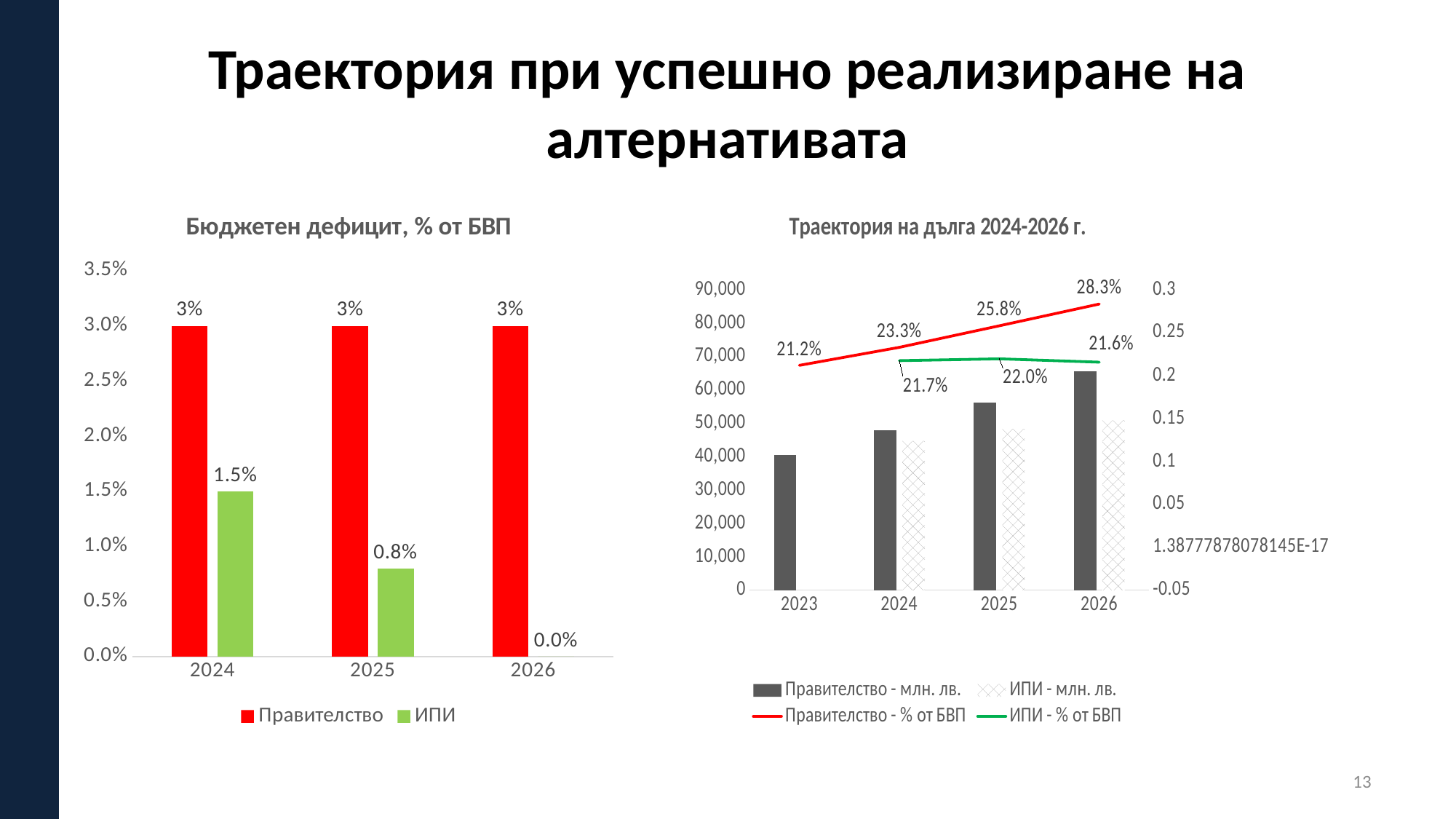
In the chart titled "Бюджетен дефицит, % от БВП", what is the value for ИПИ in 2025? 0.8% In the chart titled "Траектория на дълга 2024-2026 г.", what is the difference between Правителство - % от БВП and ИПИ - % от БВП in 2026? 6.7% In the chart titled "Траектория на дълга 2024-2026 г.", how many series does the legend list? 4 In the chart titled "Траектория на дълга 2024-2026 г.", what is the value of ИПИ - % от БВП in 2025? 22.0% In the chart titled "Бюджетен дефицит, % от БВП", how many series does the legend list? 2 In the chart titled "Бюджетен дефицит, % от БВП", in which year is the ИПИ value lowest? 2026 In the chart titled "Бюджетен дефицит, % от БВП", do the ИПИ values rise or fall from 2024 to 2026? fall In the chart titled "Бюджетен дефицит, % от БВП", what kind of chart is it? bar chart In the chart titled "Бюджетен дефицит, % от БВП", what is the value for Правителство in 2026? 3% In the chart titled "Бюджетен дефицит, % от БВП", what is the value for ИПИ in 2024? 1.5% In the chart titled "Траектория на дълга 2024-2026 г.", is the Правителство - млн. лв. bar for 2026 greater or less than 60,000? greater In the chart titled "Траектория на дълга 2024-2026 г.", what is the value of Правителство - % от БВП in 2026? 28.3%